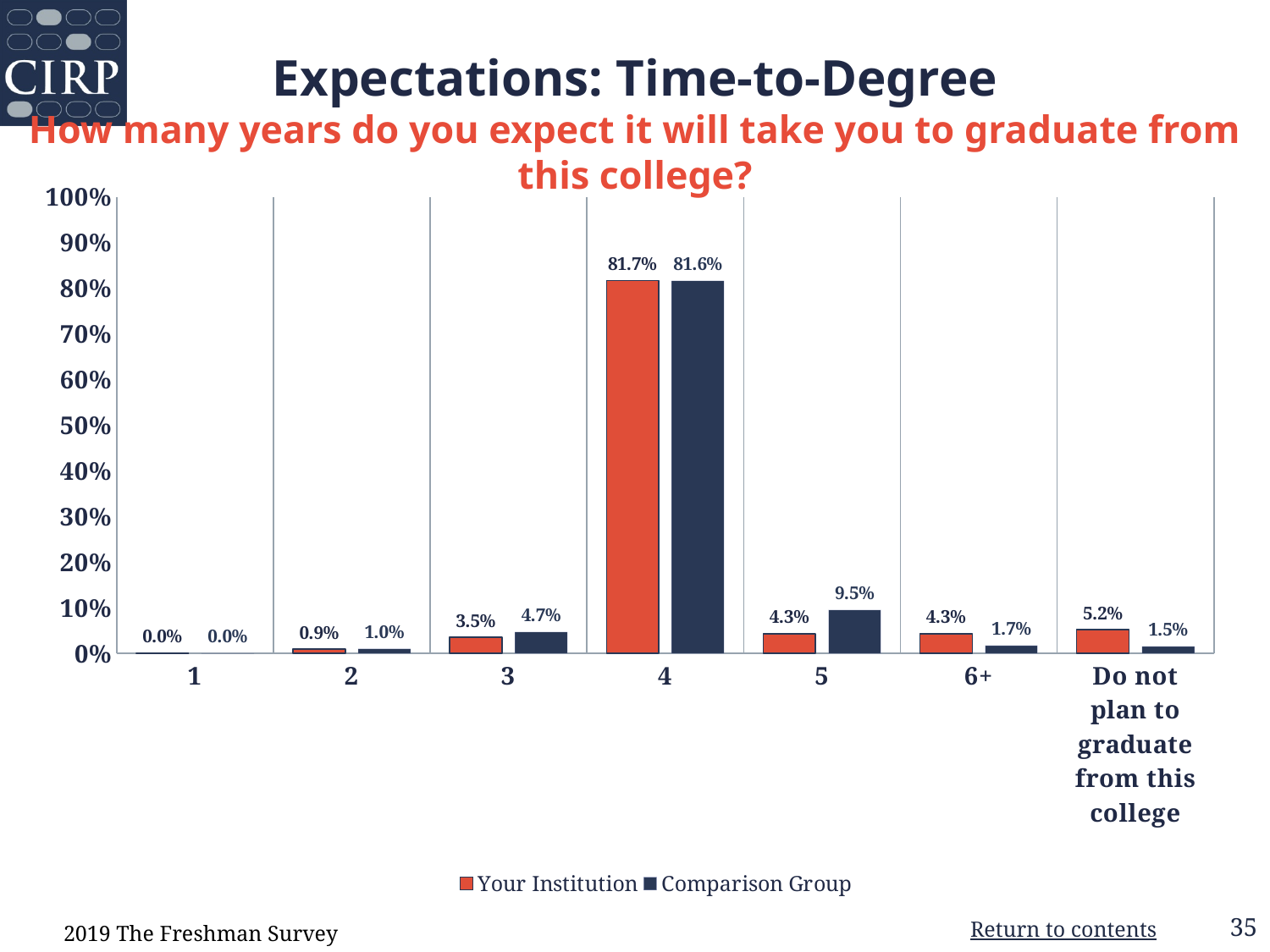
What is the value for Your Institution for category 4? 81.7% Which category has the lowest value for Comparison Group? 1 What is the value for Comparison Group for category 5? 9.5% Which category has the highest value for Your Institution? 4 How many categories are shown on the x axis? 7 What kind of chart is shown on the slide? bar chart How many series does the legend list? 2 What is the value for Comparison Group for category 6+? 1.7% What is the value for Your Institution for 'Do not plan to graduate from this college'? 5.2% What is the difference between Comparison Group and Your Institution for category 5? 5.2% Is the value for Comparison Group for category 4 greater or less than 80%? greater For category 6+, which series has the larger value, Your Institution or Comparison Group? Your Institution